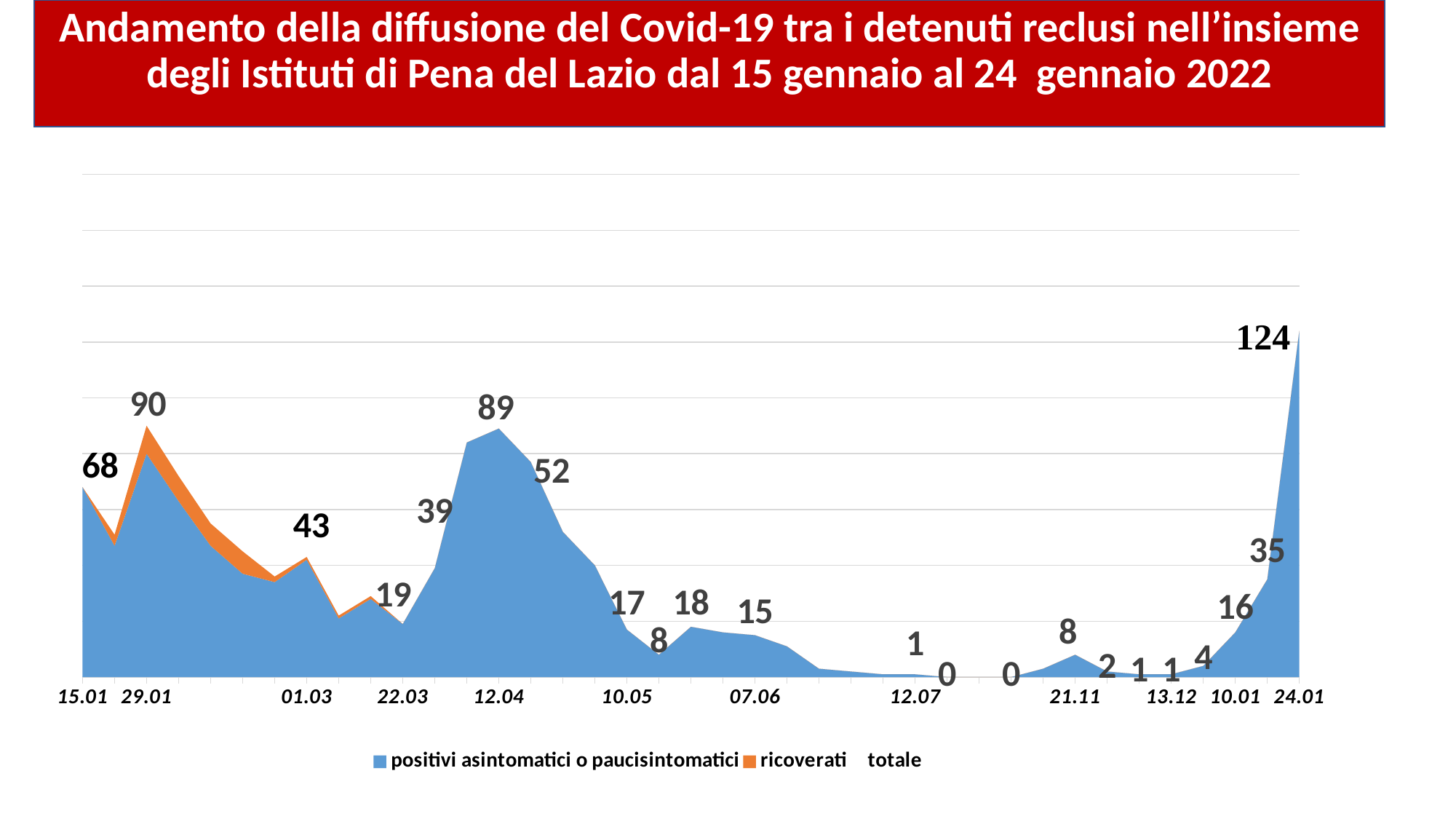
What is the total value shown for 07.06? 15 What is the difference between the total value at 24.01 and the total value at 29.01? 34 Which date has the highest total value on the chart? 24.01 What is the total value shown for 12.04? 89 What is the total value shown for 29.01? 90 Which is larger, the total value at 15.01 or at 01.03? 15.01 What is the total value shown for 15.01? 68 Do the values rise or fall from 10.01 to 24.01? Rise What is the total value shown for 24.01? 124 How many series does the legend list? 3 What is the difference between the total value at 12.04 and the value labelled 52 just after it? 37 What kind of chart is shown on the slide? Area chart